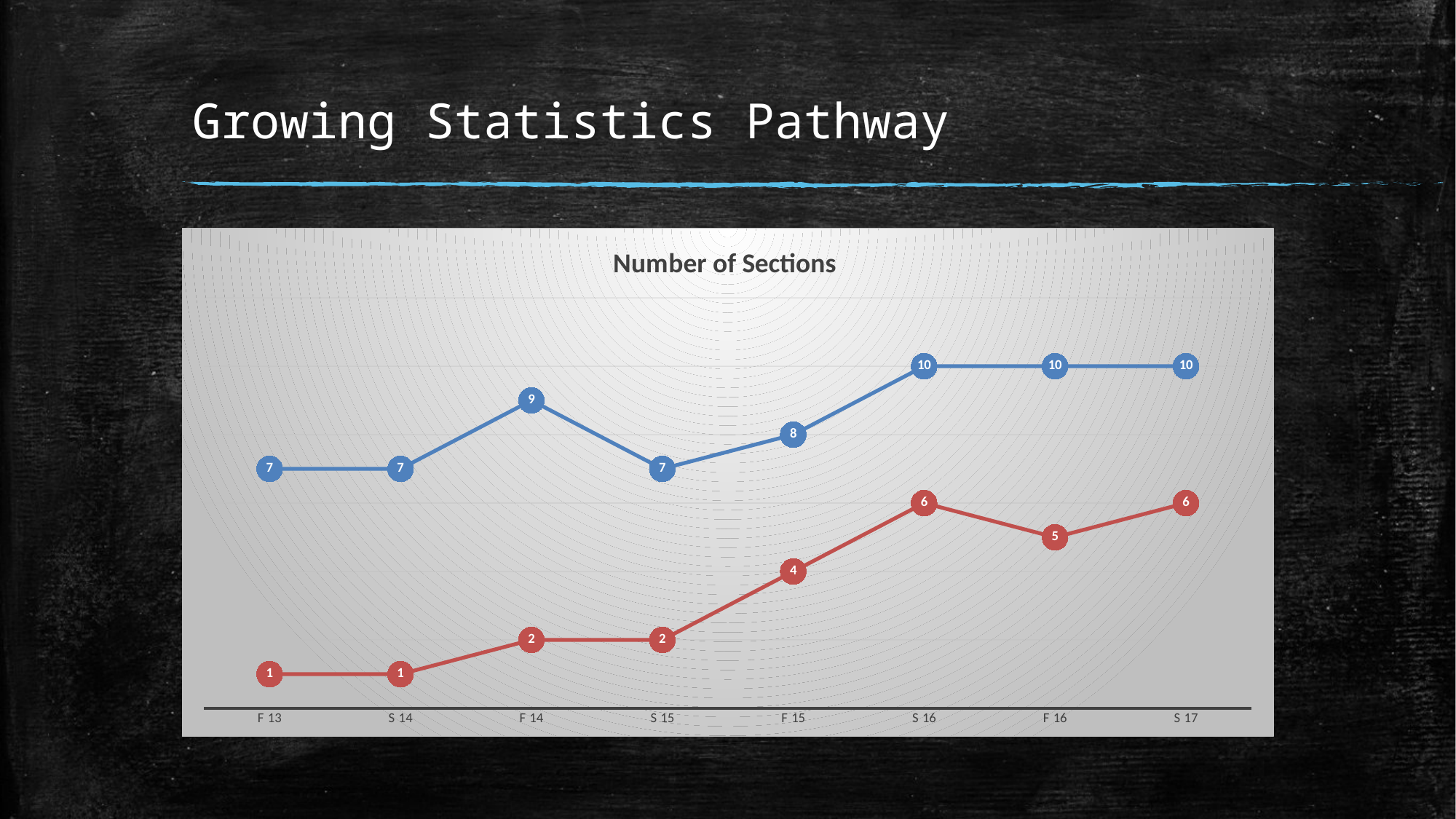
What is the difference between the blue and red series at S 17? 4 What is the value of the blue series at F 14? 9 What is the title of the chart? Number of Sections What kind of chart is shown on the slide? line chart What is the difference between the red series values at S 16 and F 16? 1 What is the value of the red series at F 16? 5 Which is larger, the blue series value at F 14 or at F 15? F 14 What is the value of the blue series at S 15? 7 What is the value of the red series at F 15? 4 At which category does the red series reach its lowest value, F 13 or F 15? F 13 What is the highest value reached by the blue series? 10 How many categories are shown on the x axis? 8